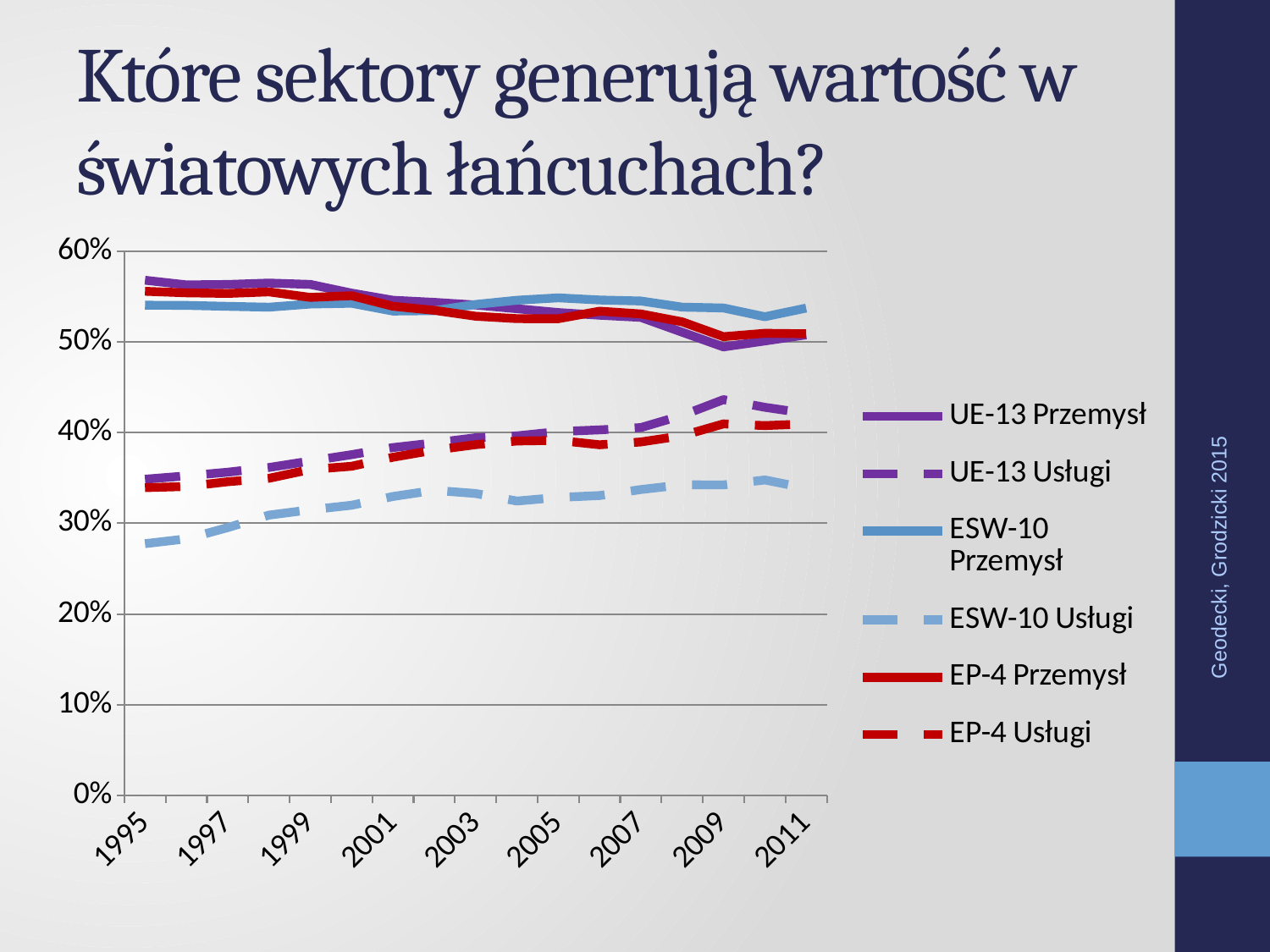
Which series is drawn with dashed lines: the Przemysł series or the Usługi series? Usługi Does the ESW-10 Usługi line rise or fall from 1995 to 2011? rise In 2011, which is larger: ESW-10 Przemysł or UE-13 Przemysł? ESW-10 Przemysł Which series has the highest value in 2011? ESW-10 Przemysł What kind of chart is shown on the slide? line chart Does the UE-13 Przemysł line rise or fall from 1995 to 2011? fall What is the title of the slide above the chart? Które sektory generują wartość w światowych łańcuchach? Which series has the lowest value in 1995? ESW-10 Usługi Is the value for UE-13 Przemysł in 1995 greater or less than 50%? greater How many series does the legend list? 6 Is the value for ESW-10 Usługi in 1995 greater or less than 30%? less